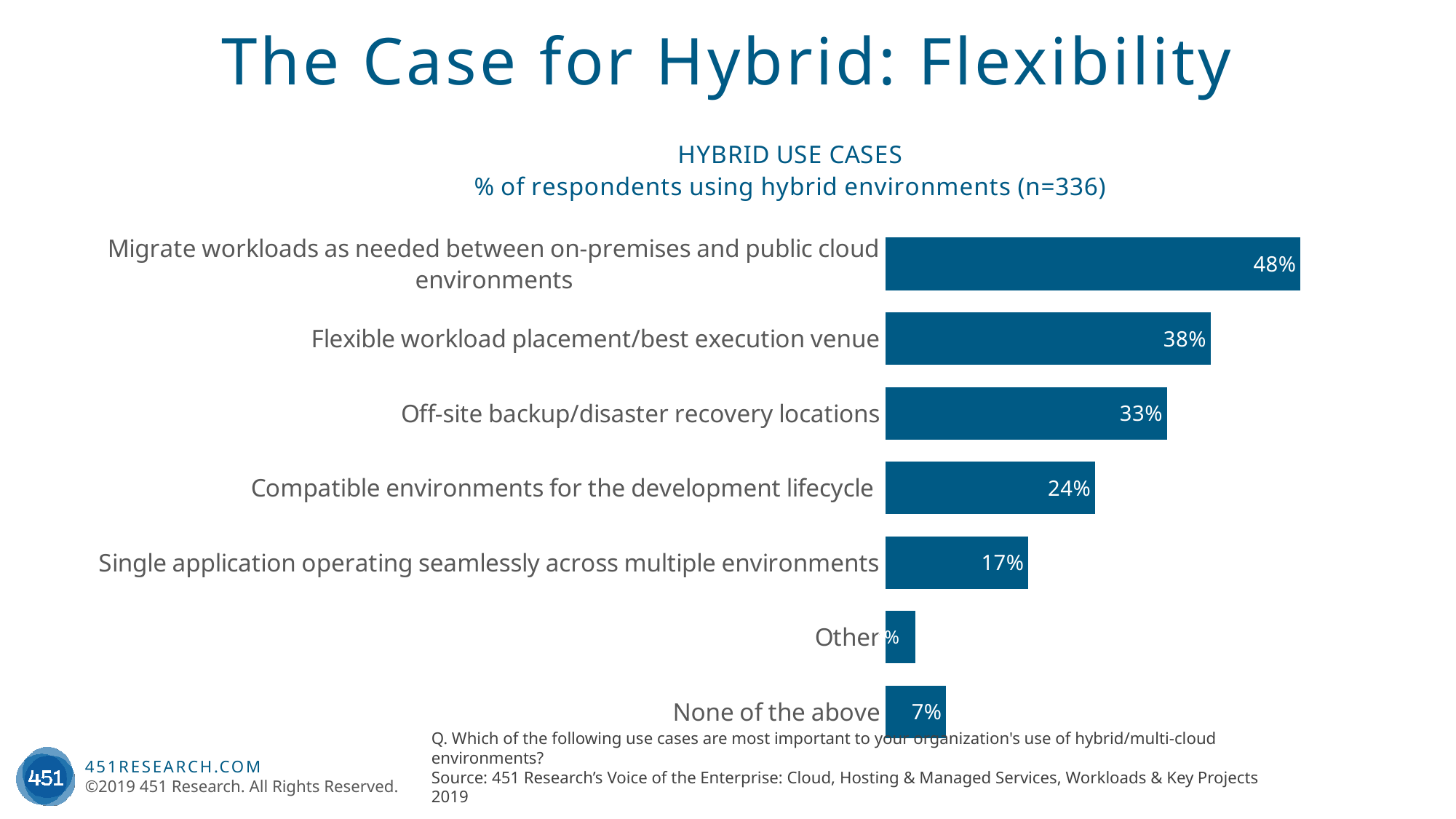
Which category has the shortest bar in the chart? Other What is the difference between "Compatible environments for the development lifecycle" and "Single application operating seamlessly across multiple environments"? 7 percentage points What is the value for "Off-site backup/disaster recovery locations"? 33% How many percentage points higher is "Migrate workloads as needed between on-premises and public cloud environments" than "Flexible workload placement/best execution venue"? 10 percentage points What percentage of respondents selected "Migrate workloads as needed between on-premises and public cloud environments"? 48% Which is larger: "Off-site backup/disaster recovery locations" or "Single application operating seamlessly across multiple environments"? Off-site backup/disaster recovery locations How many categories are shown in the chart? 7 What is the value for "Flexible workload placement/best execution venue"? 38% What percentage of respondents chose "Compatible environments for the development lifecycle"? 24% What is the value for "None of the above"? 7% What kind of chart is shown on the slide? Bar chart Which use case has the highest percentage of respondents? Migrate workloads as needed between on-premises and public cloud environments